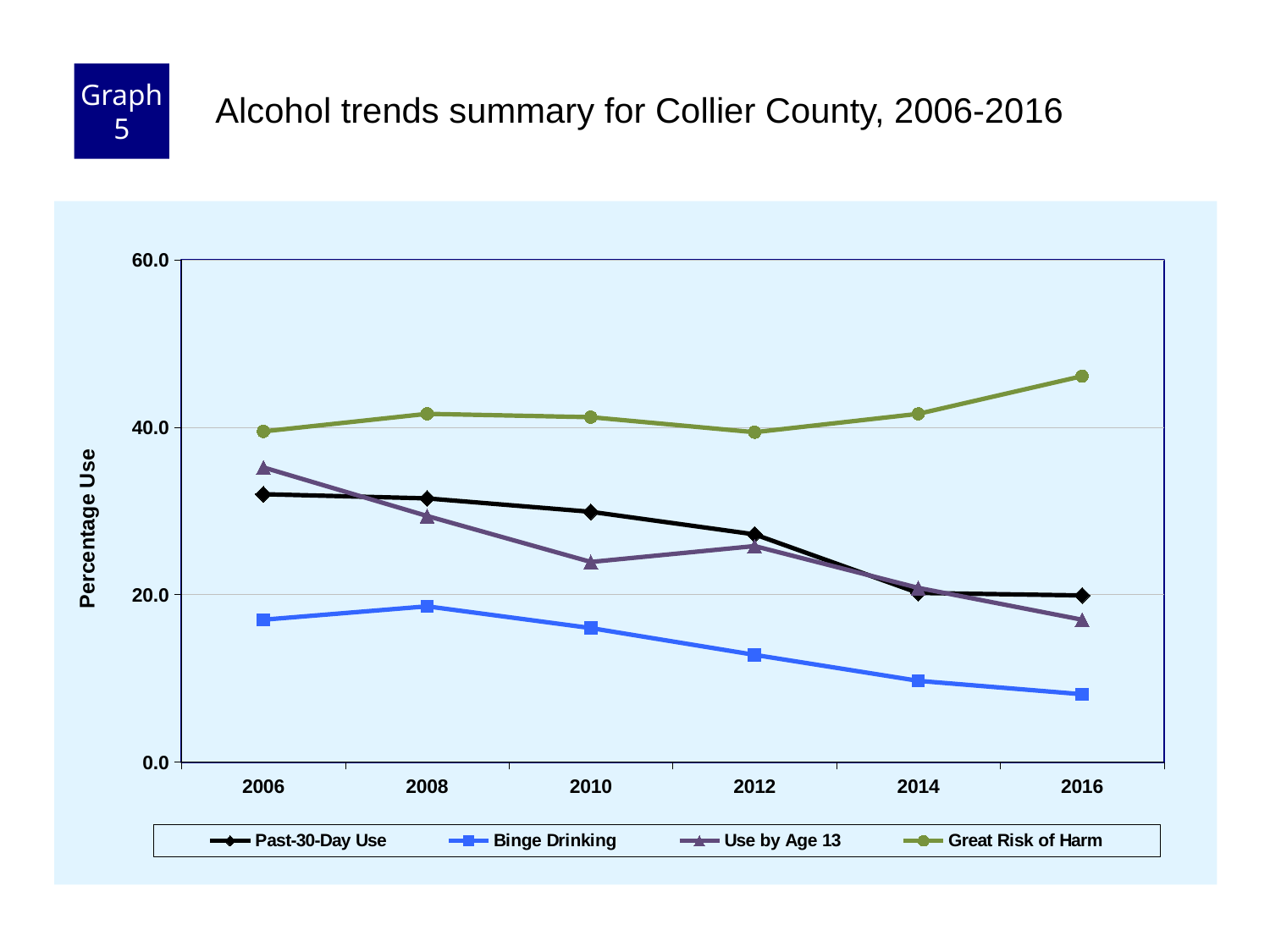
In 2010, which is larger: Past-30-Day Use or Use by Age 13? Past-30-Day Use Is the value for Great Risk of Harm in 2016 greater or less than 40? greater Does the Great Risk of Harm line rise or fall from 2012 to 2016? Rise Is the value for Binge Drinking in 2016 greater or less than 20? less How many series does the legend list? 4 Is the value for Past-30-Day Use in 2006 greater or less than 40? less Which series has the highest value in 2016? Great Risk of Harm What kind of chart is shown on the slide? Line chart Which series has the lowest value in 2006? Binge Drinking What is the label on the y axis? Percentage Use Does the Binge Drinking line rise or fall from 2008 to 2016? Fall How many years are plotted along the x axis? 6